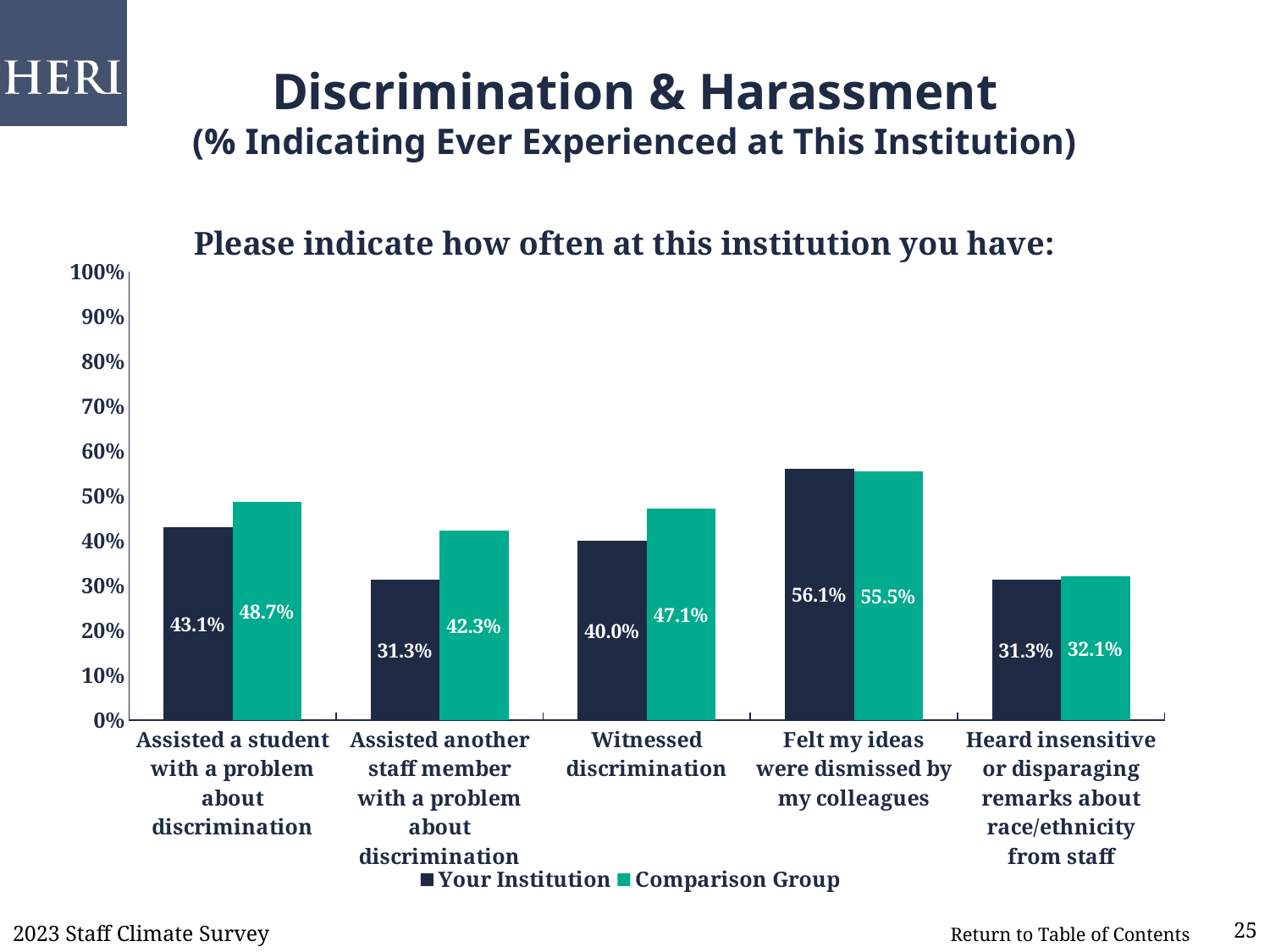
What is the value for Your Institution for "Witnessed discrimination"? 40.0% How many series does the legend list? 2 For "Witnessed discrimination", which is larger: Your Institution or Comparison Group? Comparison Group What kind of chart is shown on the slide? Bar chart What is the difference between the Comparison Group and Your Institution values for "Assisted another staff member with a problem about discrimination"? 11.0% What is the value for Your Institution for "Felt my ideas were dismissed by my colleagues"? 56.1% What are the two series named in the legend? Your Institution and Comparison Group Is the Comparison Group value for "Felt my ideas were dismissed by my colleagues" greater or less than 50%? greater How many categories are shown on the x axis? 5 What is the value for Comparison Group for "Assisted a student with a problem about discrimination"? 48.7% Which category has the lowest value for Comparison Group? Heard insensitive or disparaging remarks about race/ethnicity from staff Which category has the highest value for Your Institution? Felt my ideas were dismissed by my colleagues